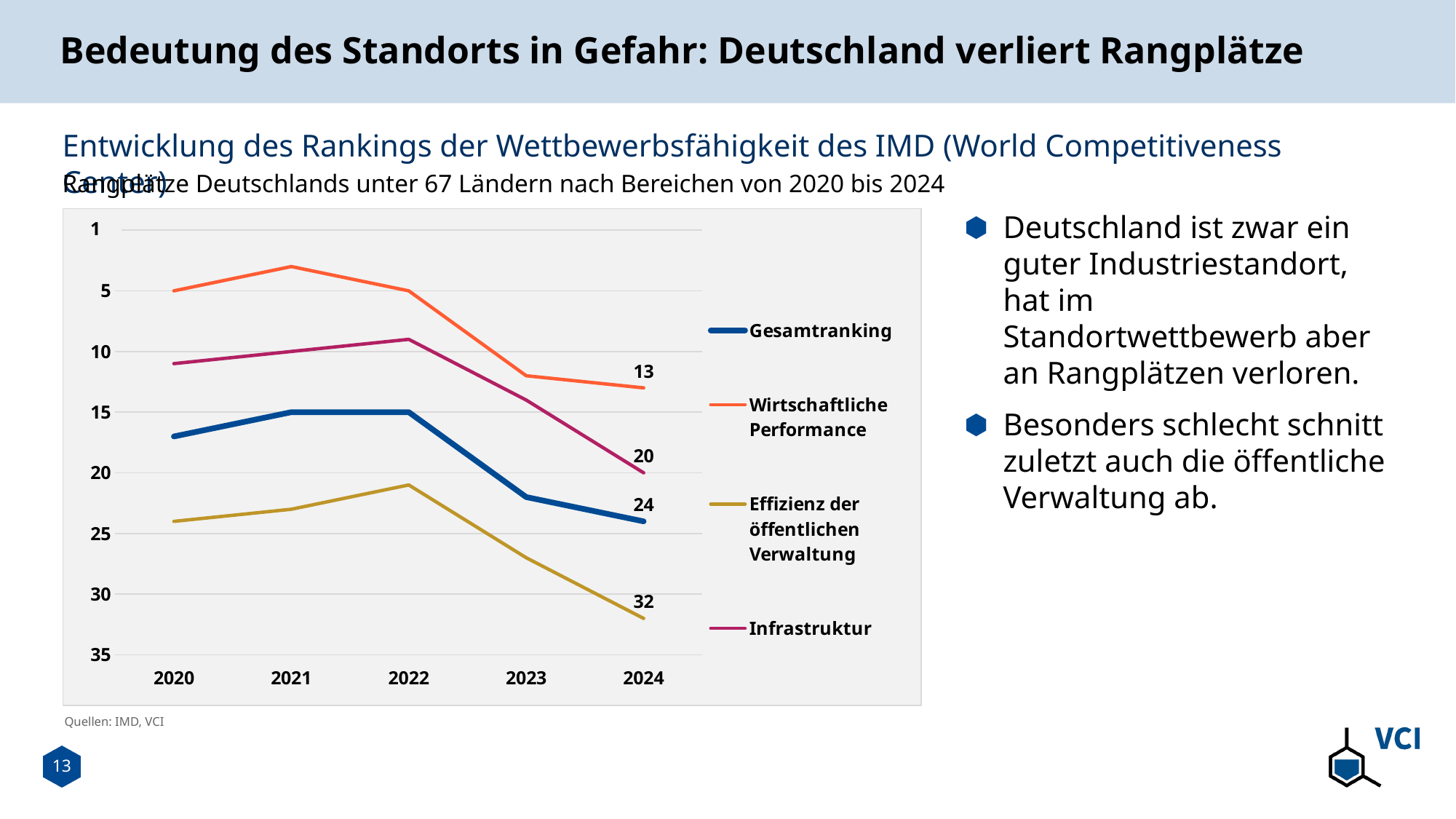
What kind of chart is shown on the slide? line chart Which series has the lowest rank number in 2024? Wirtschaftliche Performance What is the 2024 value for Infrastruktur? 20 In 2024, which has the larger rank number: Infrastruktur or Wirtschaftliche Performance? Infrastruktur What is the difference between the 2024 values for Effizienz der öffentlichen Verwaltung and Wirtschaftliche Performance? 19 What is the 2024 value for Wirtschaftliche Performance? 13 What is the 2024 value for Effizienz der öffentlichen Verwaltung? 32 What is the 2024 value for Gesamtranking? 24 How many years are shown on the x axis? 5 Which series has the highest rank number in 2024? Effizienz der öffentlichen Verwaltung Is the 2020 value for Effizienz der öffentlichen Verwaltung greater or less than 25? less How many series does the legend list? 4